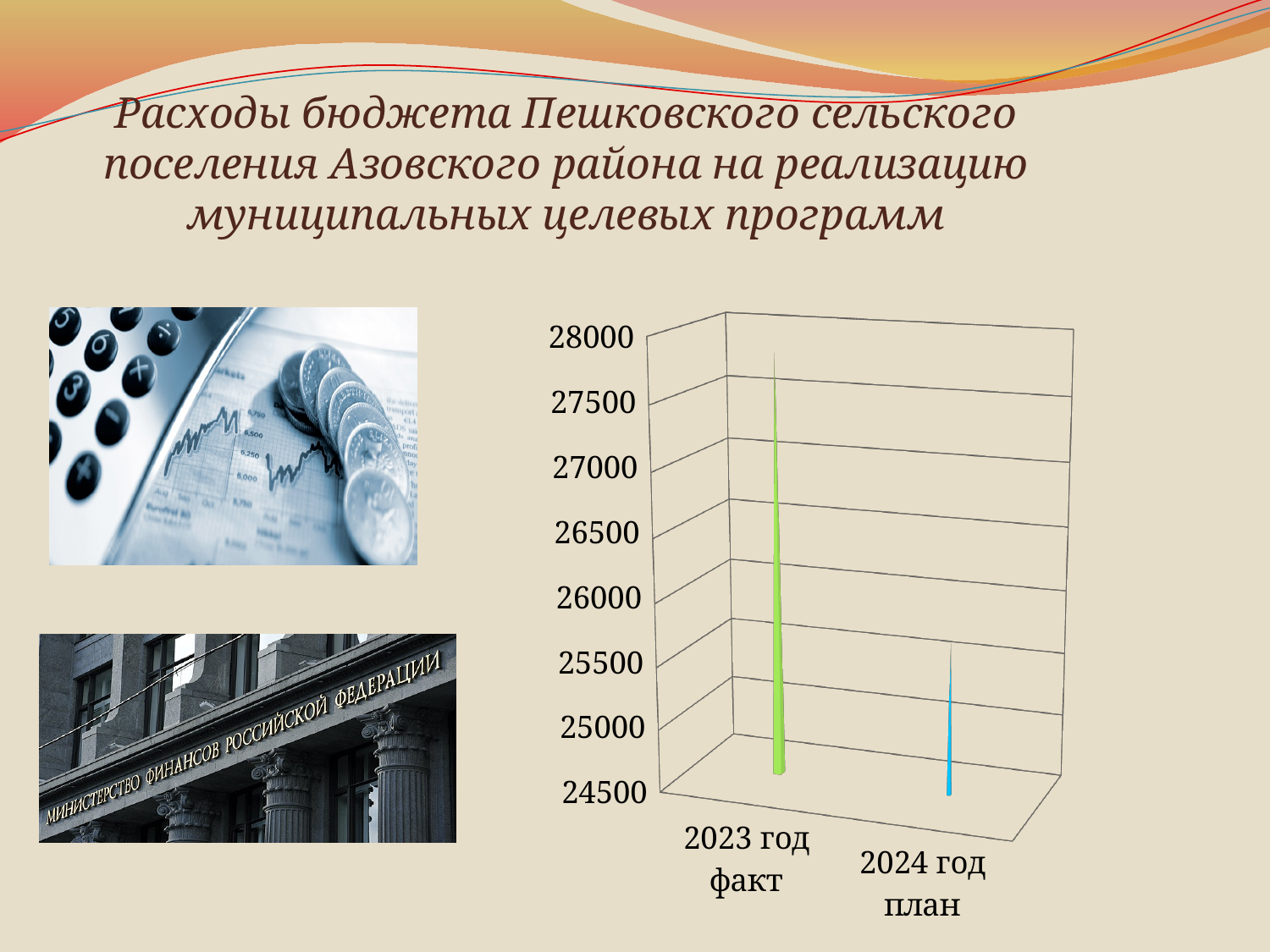
Is the value for 2023 год факт greater or less than 27000? greater What colour is the bar for 2024 год план? blue Which category has the lowest value in the chart? 2024 год план What kind of chart is shown on the slide? bar chart Is the value for 2024 год план greater or less than 26000? less Which category has the highest value in the chart? 2023 год факт Do the values rise or fall from 2023 год факт to 2024 год план? fall How many categories are shown on the x axis of the chart? 2 Which is larger, the value for 2023 год факт or the value for 2024 год план? 2023 год факт Is the value for 2023 год факт greater or less than 26500? greater What is the lowest value shown on the vertical axis of the chart? 24500